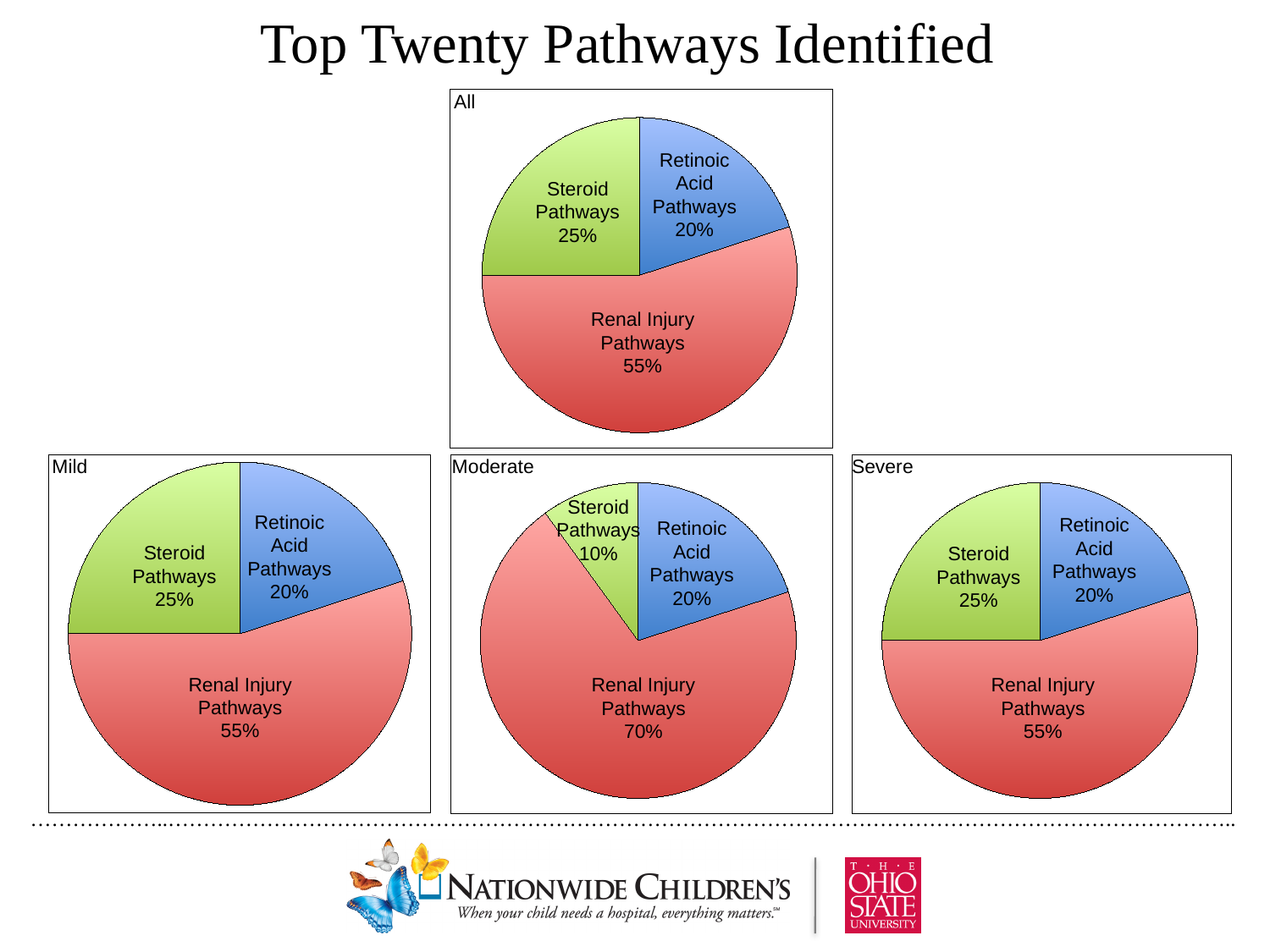
How many pie charts are shown on the slide? 4 In the "Moderate" pie chart, what share do Renal Injury Pathways have? 70% In the "All" pie chart, what is the difference between the Renal Injury Pathways share and the Steroid Pathways share? 30% In the "Moderate" pie chart, what share do Steroid Pathways have? 10% In the "Moderate" pie chart, which category has the smallest share? Steroid Pathways In the "Severe" pie chart, which is larger: Steroid Pathways or Retinoic Acid Pathways? Steroid Pathways How many slices does the "Mild" pie chart have? 3 In the "All" pie chart, what share do Renal Injury Pathways have? 55% In the "Moderate" pie chart, what is the difference between the Retinoic Acid Pathways share and the Steroid Pathways share? 10% In the "Severe" pie chart, what share do Retinoic Acid Pathways have? 20% In the "Mild" pie chart, which category has the largest share? Renal Injury Pathways What type of chart is used in the "All" panel? Pie chart